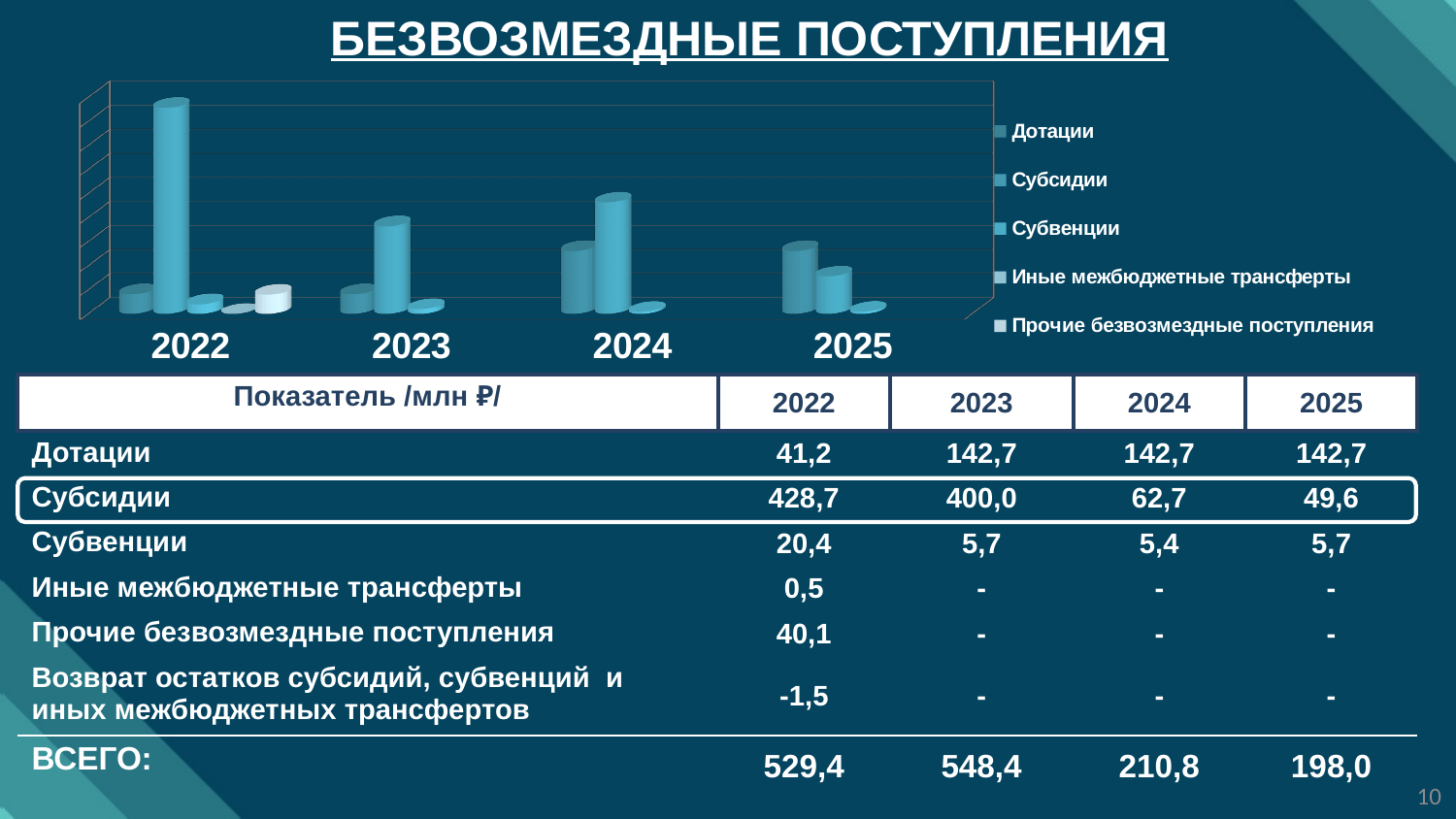
What is the value of Субсидии for 2023 (млн ₽)? 400,0 What is the difference between Субсидии in 2022 and Субсидии in 2025 (млн ₽)? 379,1 What is the total (ВСЕГО) for 2024 (млн ₽)? 210,8 What is the value of Дотации for 2022 (млн ₽)? 41,2 In 2022, which is larger: Дотации or Субсидии? Субсидии How many series does the chart legend list? 5 What kind of chart is shown on the slide? bar chart Which year has the tallest bar for Субсидии? 2022 How many years are shown along the x axis of the chart? 4 Do the values for Субсидии rise or fall from 2022 to 2025? fall What is the title of the slide above the chart? БЕЗВОЗМЕЗДНЫЕ ПОСТУПЛЕНИЯ